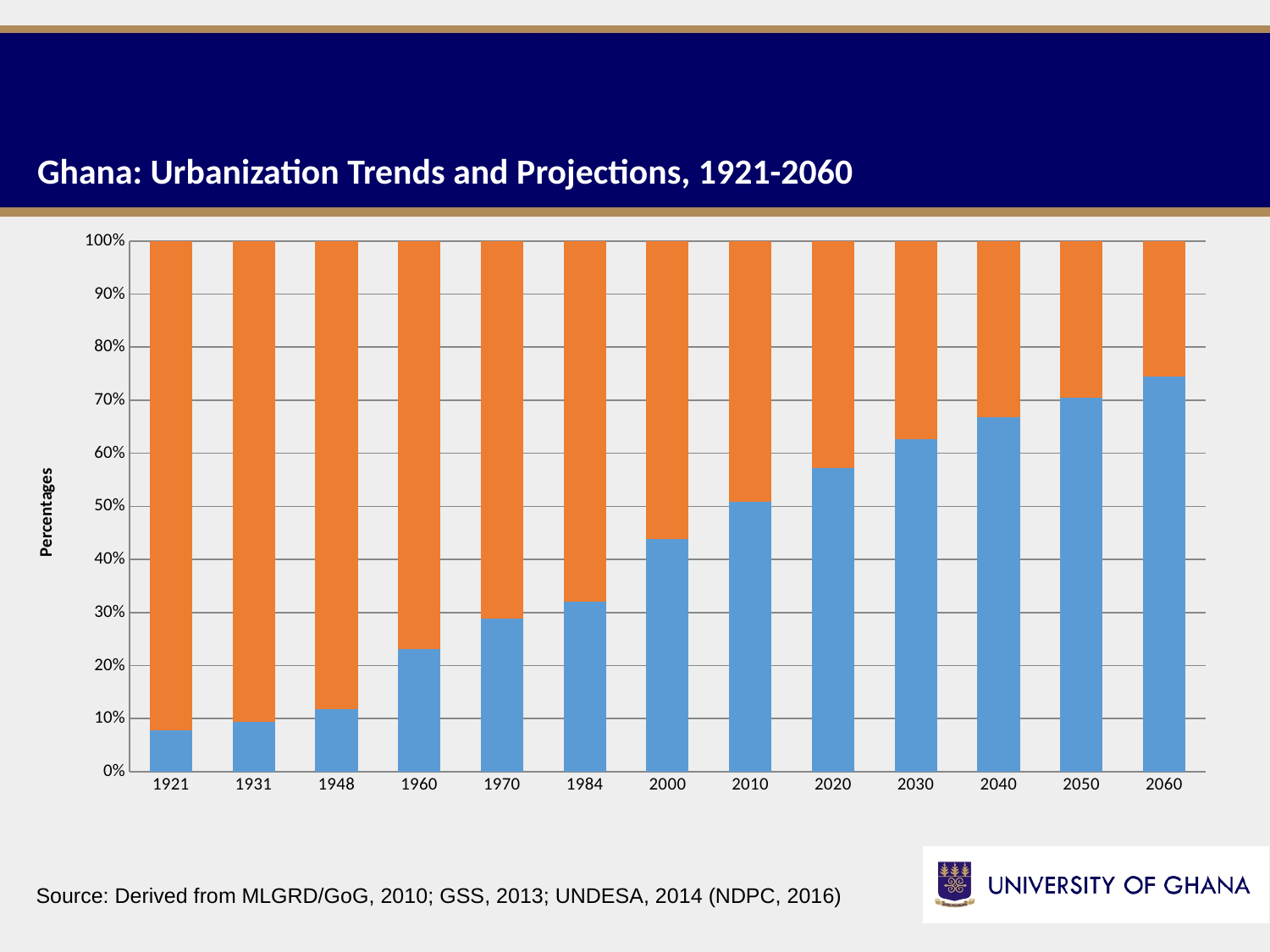
Which year has a larger blue segment, 1948 or 2000? 2000 Does the blue segment rise or fall as the years move from 1921 to 2060? Rises What kind of chart is shown on the slide? Stacked bar chart Is the blue segment for 1960 greater or less than 20%? greater Is the blue segment for 2040 greater or less than 70%? less In which year is the blue segment of the bar the tallest? 2060 How many years are shown along the x axis of the chart? 13 In which year is the blue segment of the bar the shortest? 1921 Is the blue segment for 1921 greater or less than 10%? less What is the title of the chart? Ghana: Urbanization Trends and Projections, 1921-2060 What is the label on the vertical axis of the chart? Percentages